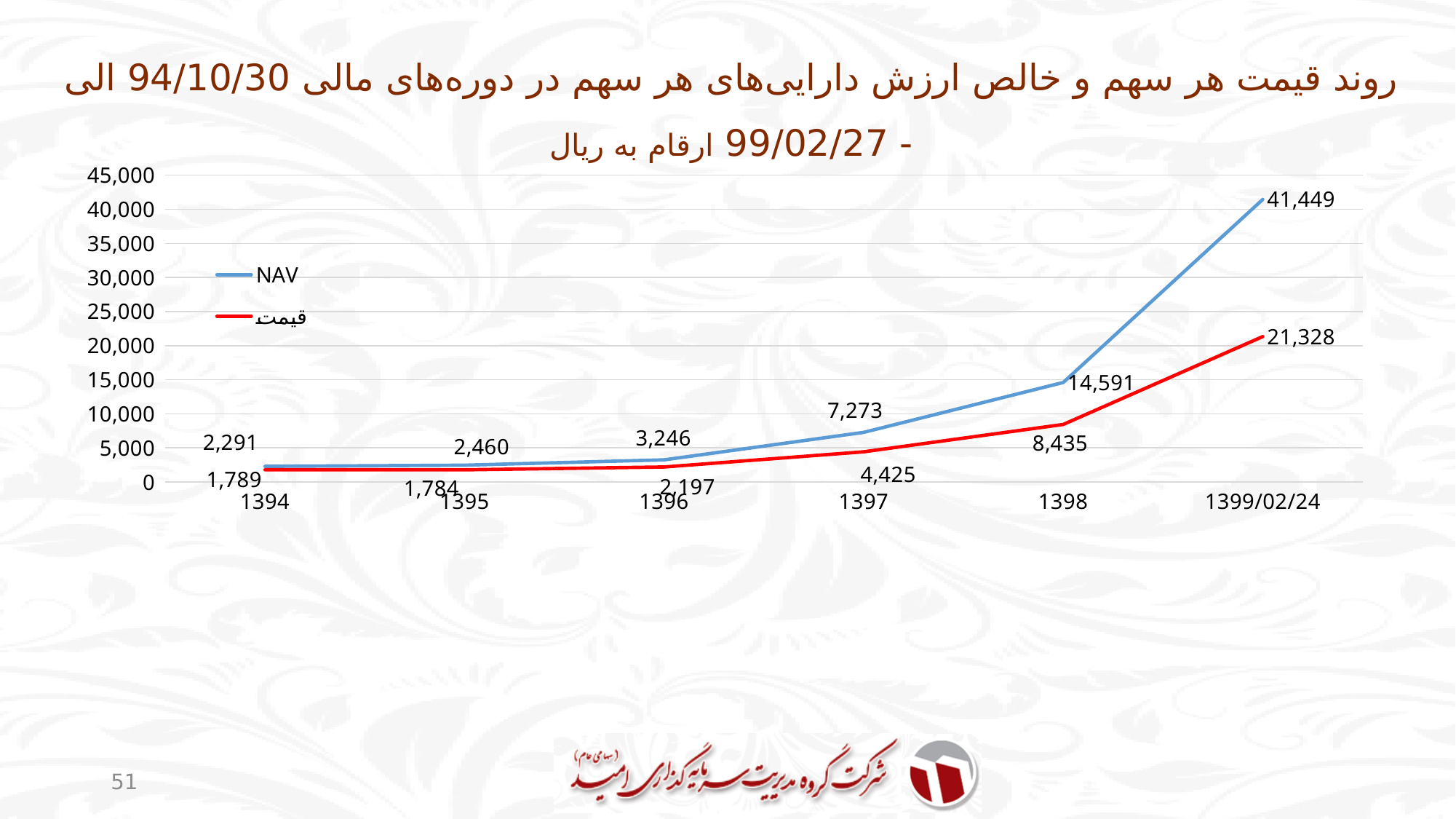
Which is larger in 1398, the NAV value or the قیمت value? NAV Does the NAV series rise or fall from 1394 to 1399/02/24? rise What is the difference between the NAV and قیمت values for 1399/02/24? 20,121 What type of chart is shown on the slide? line chart What is the NAV value for 1397? 7,273 In which period is the NAV value highest? 1399/02/24 What is the قیمت value for 1395? 1,784 In which period is the قیمت value lowest? 1395 What is the قیمت value for 1398? 8,435 How many series does the legend list? 2 What is the NAV value for 1399/02/24? 41,449 How many points are plotted along the x axis for each series? 6